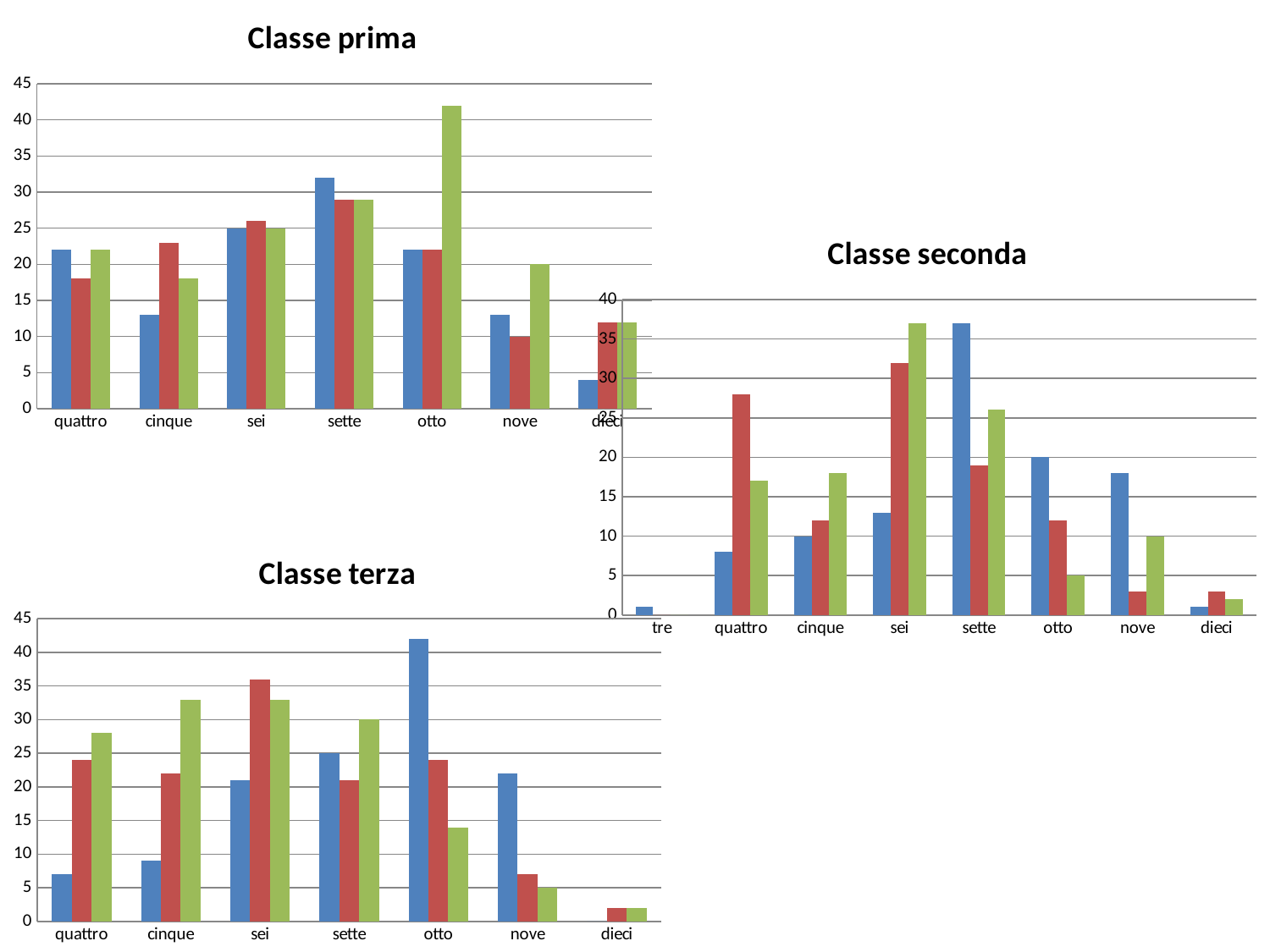
What kind of chart is the 'Classe prima' chart? bar chart How many bar series are plotted for each category in the 'Classe prima' chart? 3 How many categories are shown on the x axis of the 'Classe terza' chart? 7 In the 'Classe prima' chart, is the green bar for 'otto' greater or less than 40? greater In the 'Classe terza' chart, which is larger for 'cinque': the blue bar or the green bar? the green bar In the 'Classe terza' chart, is the blue bar for 'otto' greater or less than 40? greater In the 'Classe prima' chart, which category contains the tallest bar? otto In the 'Classe prima' chart, is the blue bar for 'sette' greater or less than 30? greater In the 'Classe terza' chart, which category contains the tallest bar? otto How many categories are shown on the x axis of the 'Classe seconda' chart? 8